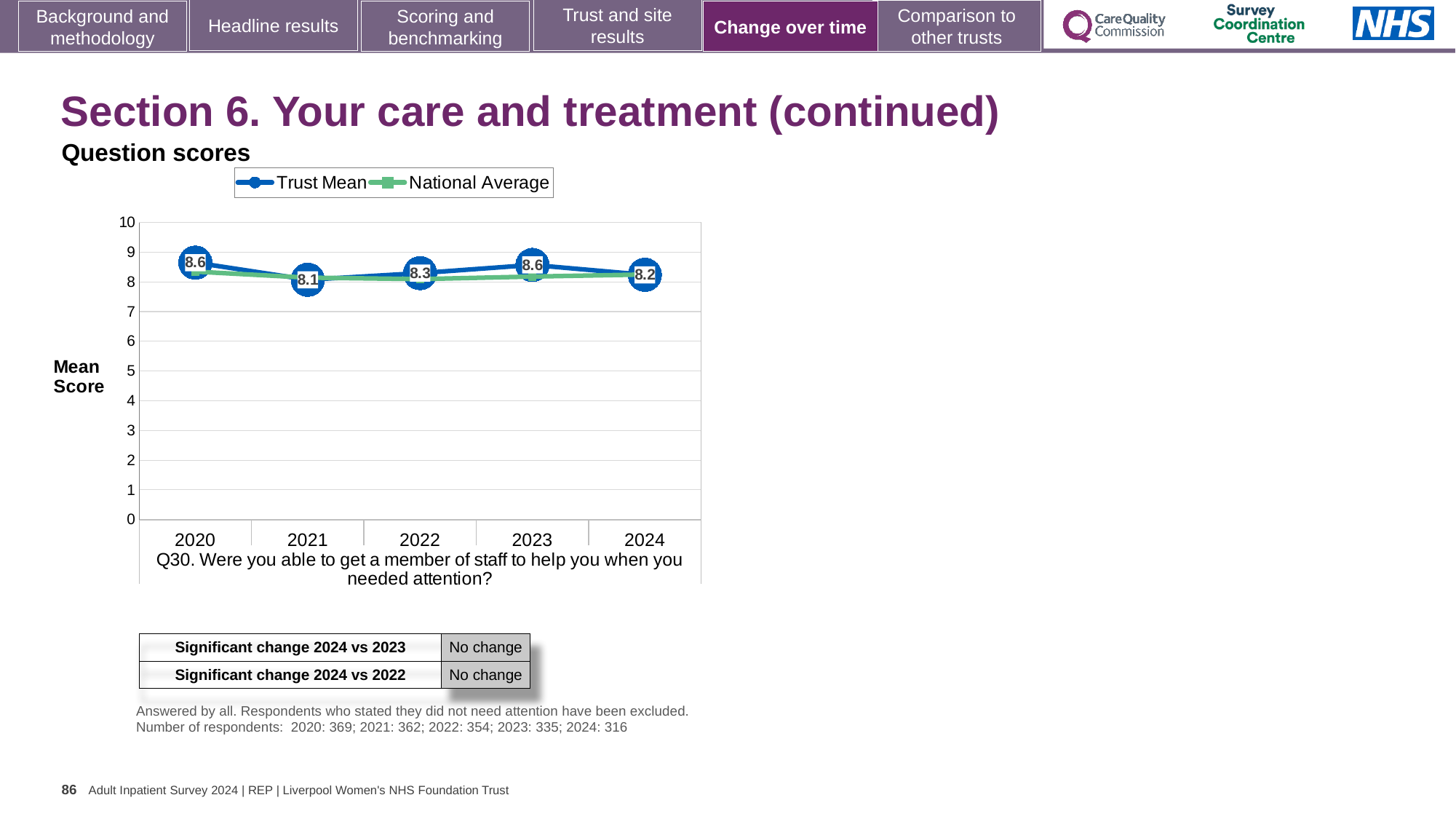
Does the Trust Mean score rise or fall from 2023 to 2024? fall How many series does the legend list? 2 Is the National Average value for 2024 greater or less than 7? greater In which year is the Trust Mean score lowest? 2021 What is the difference between the Trust Mean scores for 2020 and 2021? 0.5 What is the Trust Mean score for 2021? 8.1 What is the Trust Mean score for 2022? 8.3 What kind of chart is shown? line chart What is the Trust Mean score for 2024? 8.2 How many years are plotted on the x axis? 5 Is the National Average value for 2020 greater or less than 9? less Which year has the higher Trust Mean score, 2023 or 2024? 2023